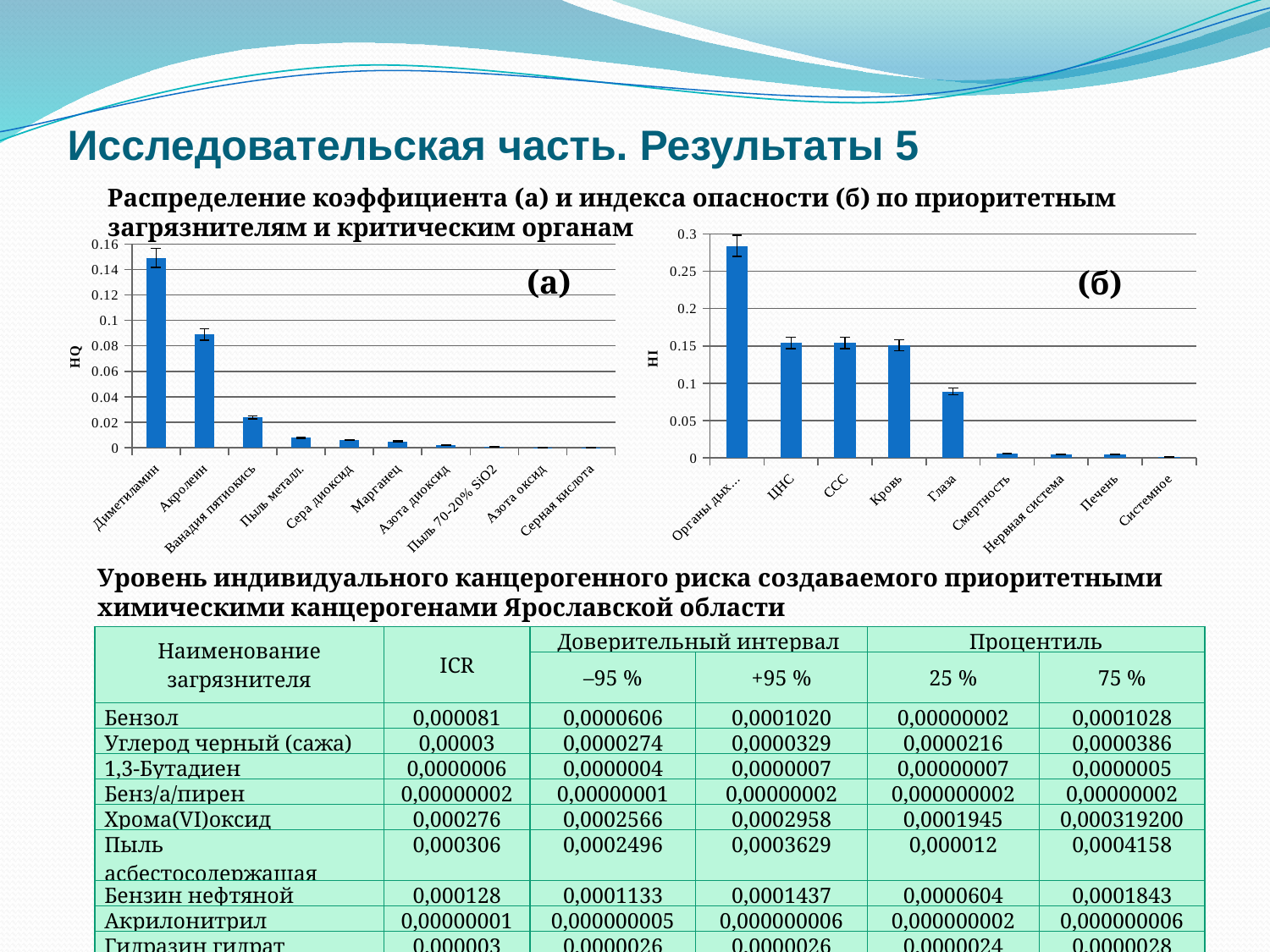
In chart (б), is the value for Глаза greater or less than 0.1? less In chart (б), which is larger, the value for Кровь or the value for Глаза? Кровь In chart (б), is the value for Органы дых... greater or less than 0.25? greater In chart (а), which is larger, the value for Акролеин or the value for Пыль металл.? Акролеин What type of chart is chart (б)? bar chart In chart (б), which category has the highest HI value? Органы дых... In chart (а), which category has the highest HQ value? Диметиламин In chart (а), is the value for Акролеин greater or less than 0.1? less How many categories are shown on the x axis of chart (б)? 9 How many categories are shown on the x axis of chart (а)? 10